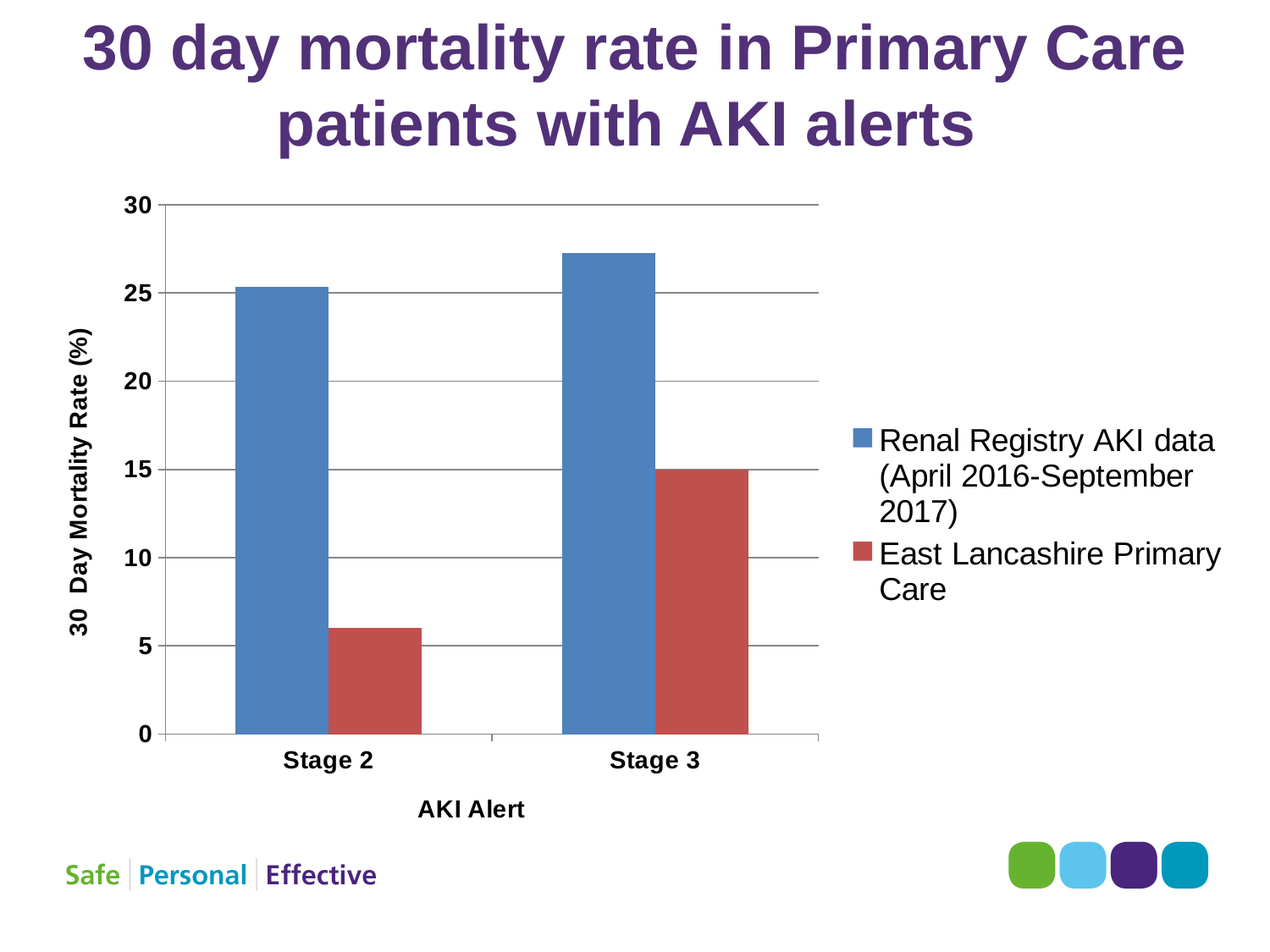
What is the label of the y axis? 30 Day Mortality Rate (%) Which bar on the chart is the highest? Renal Registry AKI data, Stage 3 Does the East Lancashire Primary Care mortality rate rise or fall from Stage 2 to Stage 3? rise How many series does the legend list? 2 What colour are the East Lancashire Primary Care bars? red Which series has the higher 30 day mortality rate for Stage 3? Renal Registry AKI data (April 2016-September 2017) Which series has the higher 30 day mortality rate for Stage 2: Renal Registry AKI data or East Lancashire Primary Care? Renal Registry AKI data (April 2016-September 2017) Which bar on the chart is the lowest? East Lancashire Primary Care, Stage 2 How many AKI Alert categories are shown on the x axis? 2 What kind of chart is shown on the slide? bar chart Is the 30 day mortality rate for Renal Registry AKI data at Stage 3 greater or less than 25? greater Is the 30 day mortality rate for East Lancashire Primary Care at Stage 2 greater or less than 10? less